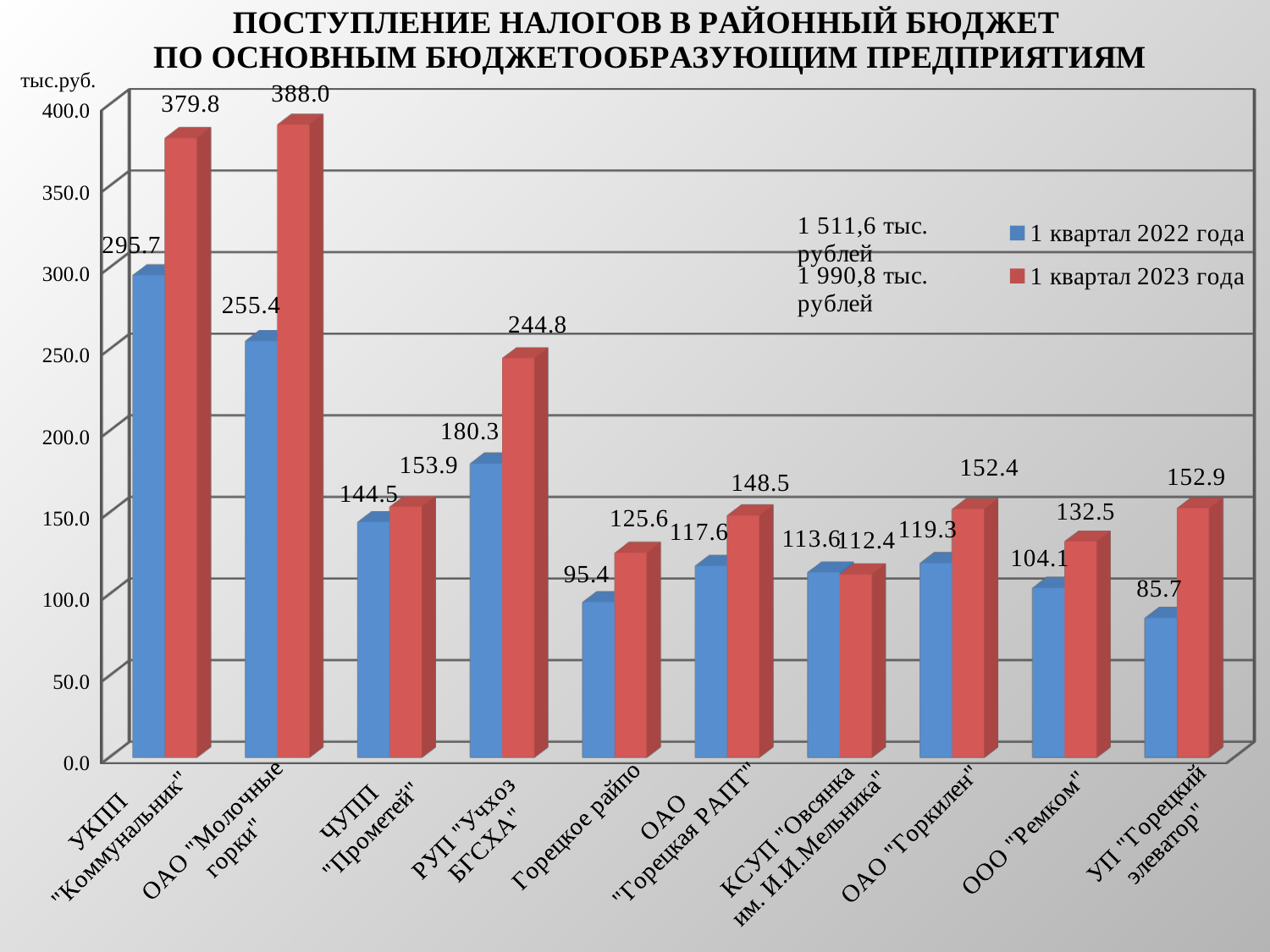
Which category has the highest value in the 1 квартал 2023 года series? ОАО "Молочные горки" Is the value for Горецкое райпо in the 1 квартал 2022 года series greater or less than 100.0? less For КСУП "Овсянка им. И.И.Мельника", which series has the larger value: 1 квартал 2022 года or 1 квартал 2023 года? 1 квартал 2022 года How many series does the legend list? 2 Which category has the lowest value in the 1 квартал 2022 года series? УП "Горецкий элеватор" What is the difference between the 1 квартал 2023 года and 1 квартал 2022 года values for РУП "Учхоз БГСХА"? 64.5 How many categories (enterprises) are shown on the x axis? 10 What is the value for ОАО "Молочные горки" in the 1 квартал 2023 года series? 388.0 What is the value for УКПП "Коммунальник" in the 1 квартал 2022 года series? 295.7 What kind of chart is shown on the slide? bar chart What unit is shown on the vertical axis label? тыс.руб. What is the value for УП "Горецкий элеватор" in the 1 квартал 2022 года series? 85.7